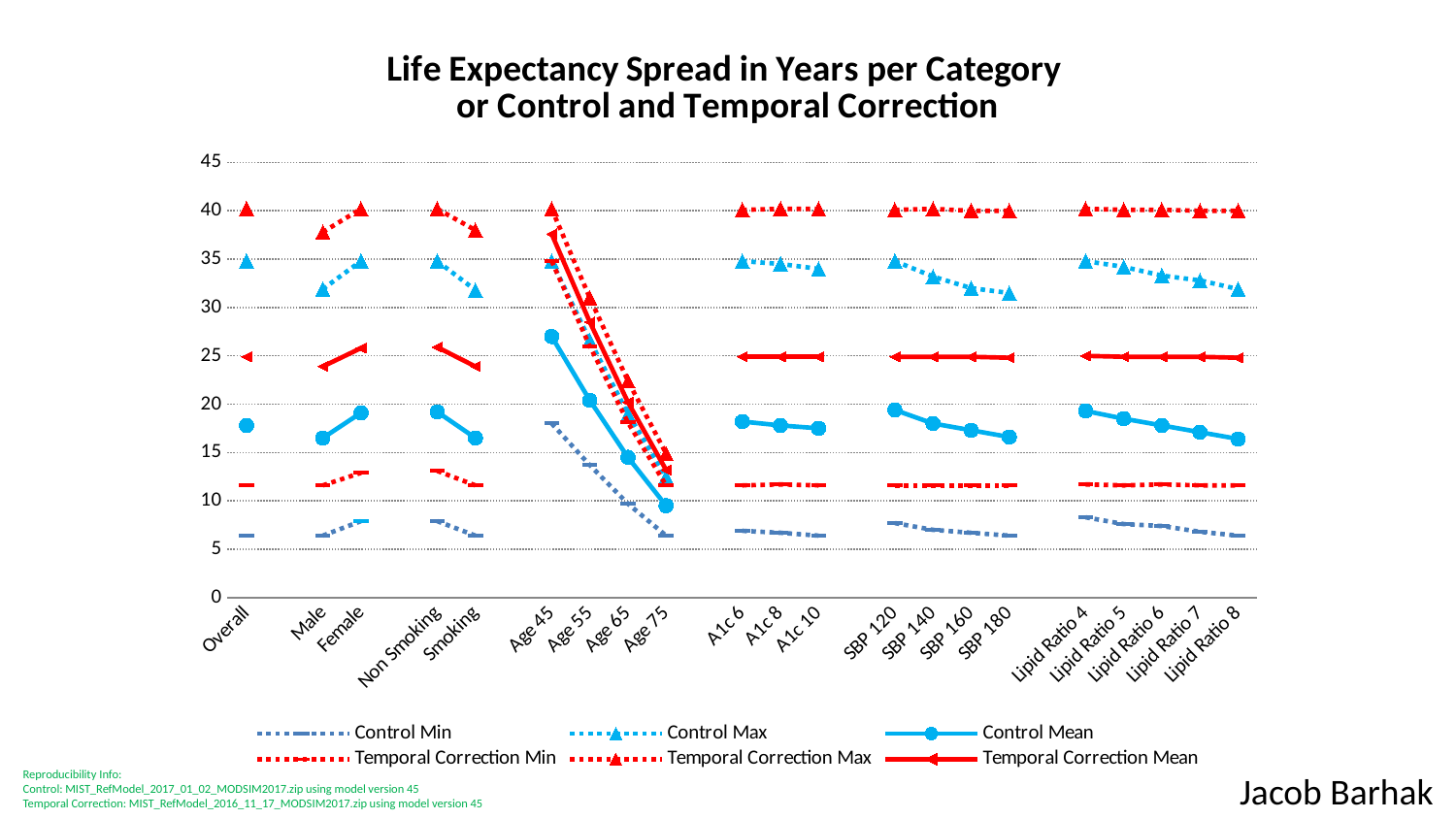
Is the Control Mean value for Age 45 greater or less than 25? greater Does the Control Mean rise or fall from Age 45 to Age 75? fall Does the Control Max rise or fall from SBP 120 to SBP 180? fall What is the title of the chart? Life Expectancy Spread in Years per Category or Control and Temporal Correction Is the Control Min value for Age 75 greater or less than 10? less How many categories are shown along the x axis? 21 Which has the larger Control Mean value, Male or Female? Female Among the Age categories, which has the highest Control Mean value? Age 45 How many series does the legend list? 6 What kind of chart is shown on the slide? line chart Is the Control Max value for Age 75 greater or less than 15? less